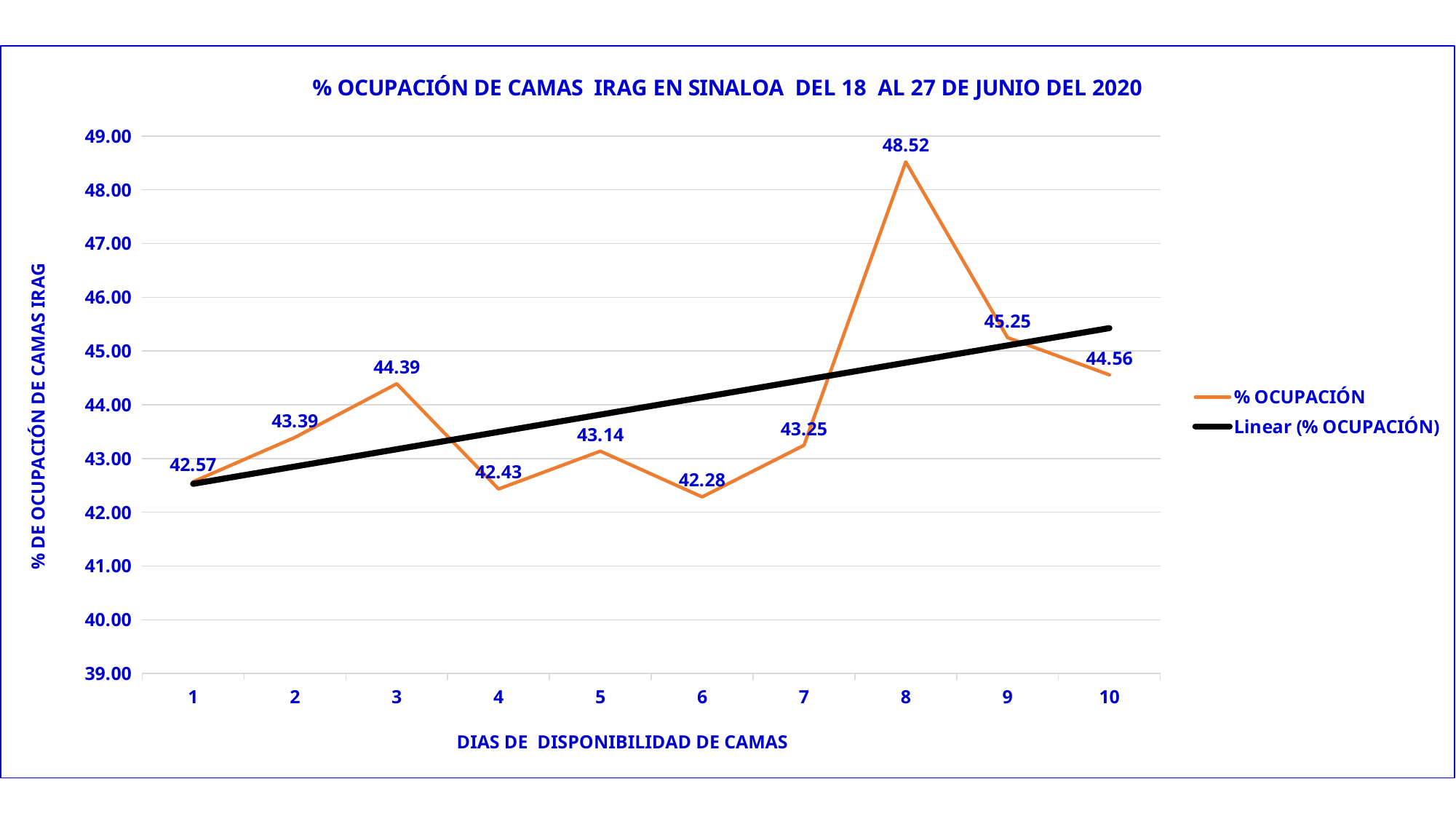
What is the % OCUPACIÓN value for day 1? 42.57 Which is larger, the % OCUPACIÓN value for day 3 or for day 5? day 3 What is the % OCUPACIÓN value for day 10? 44.56 What is the title of the chart? % OCUPACIÓN DE CAMAS IRAG EN SINALOA DEL 18 AL 27 DE JUNIO DEL 2020 How many series does the legend list? 2 Is the % OCUPACIÓN value for day 8 greater or less than 48.00? greater What is the difference between the % OCUPACIÓN values for day 8 and day 9? 3.27 What kind of chart is shown on the slide? line chart How many days are plotted on the x axis? 10 Which day has the highest % OCUPACIÓN value? 8 Which day has the lowest % OCUPACIÓN value? 6 What is the % OCUPACIÓN value for day 8? 48.52